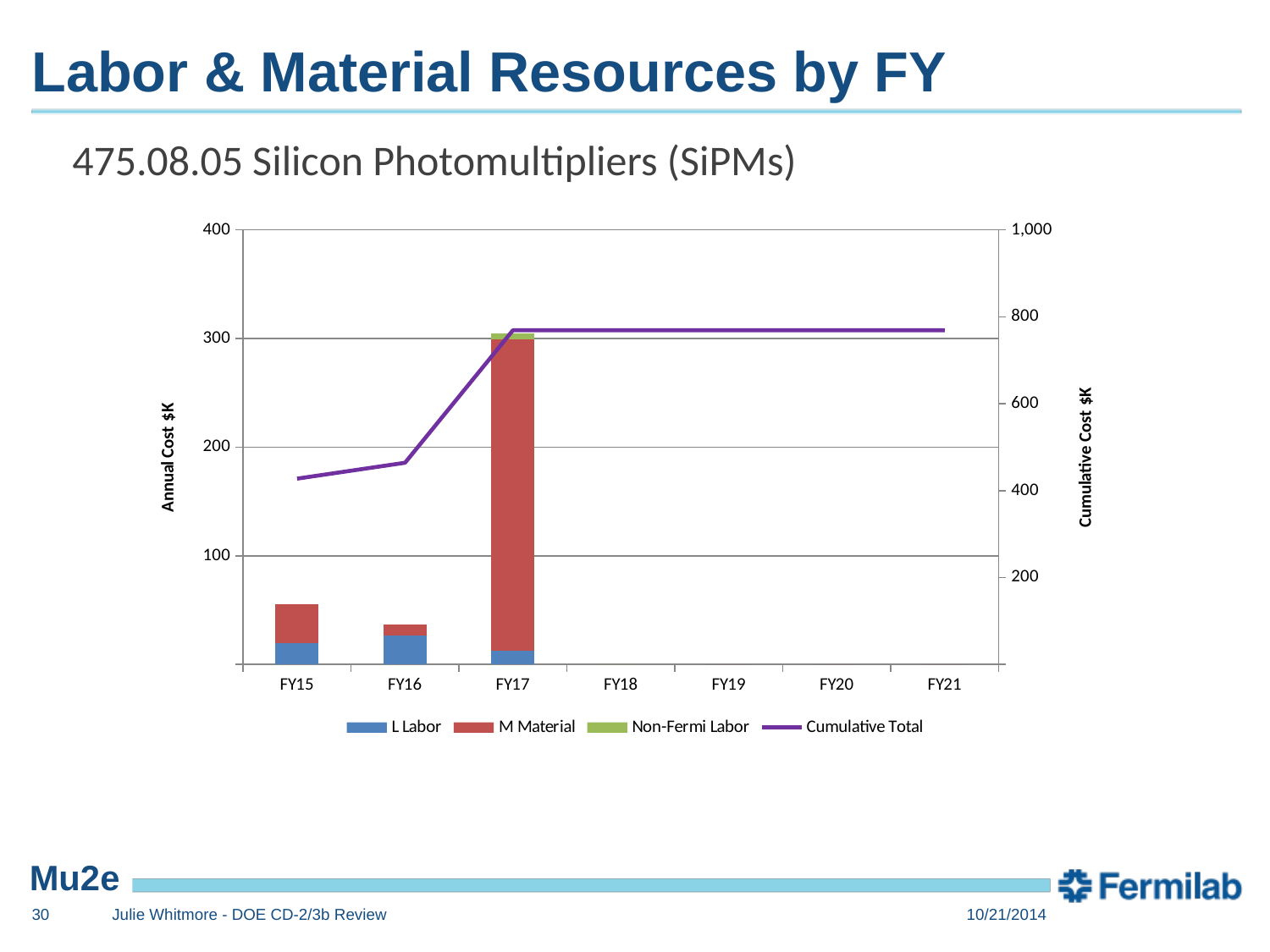
Is the total annual cost for FY15 greater or less than 100? less Of the fiscal years with bars shown, which has the lowest total annual cost? FY16 What kind of chart is shown on the slide? Stacked bar chart with a line Which has the larger total annual cost bar, FY15 or FY16? FY15 How many series does the legend list? 4 What is the label of the right-hand vertical axis? Cumulative Cost $K Does the Cumulative Total line rise or fall from FY15 to FY17? rise Is the Cumulative Total for FY21 greater or less than 800? less How many fiscal year categories are shown on the x axis? 7 Which fiscal year has the highest total annual cost bar? FY17 Is the Cumulative Total for FY15 greater or less than 400? greater